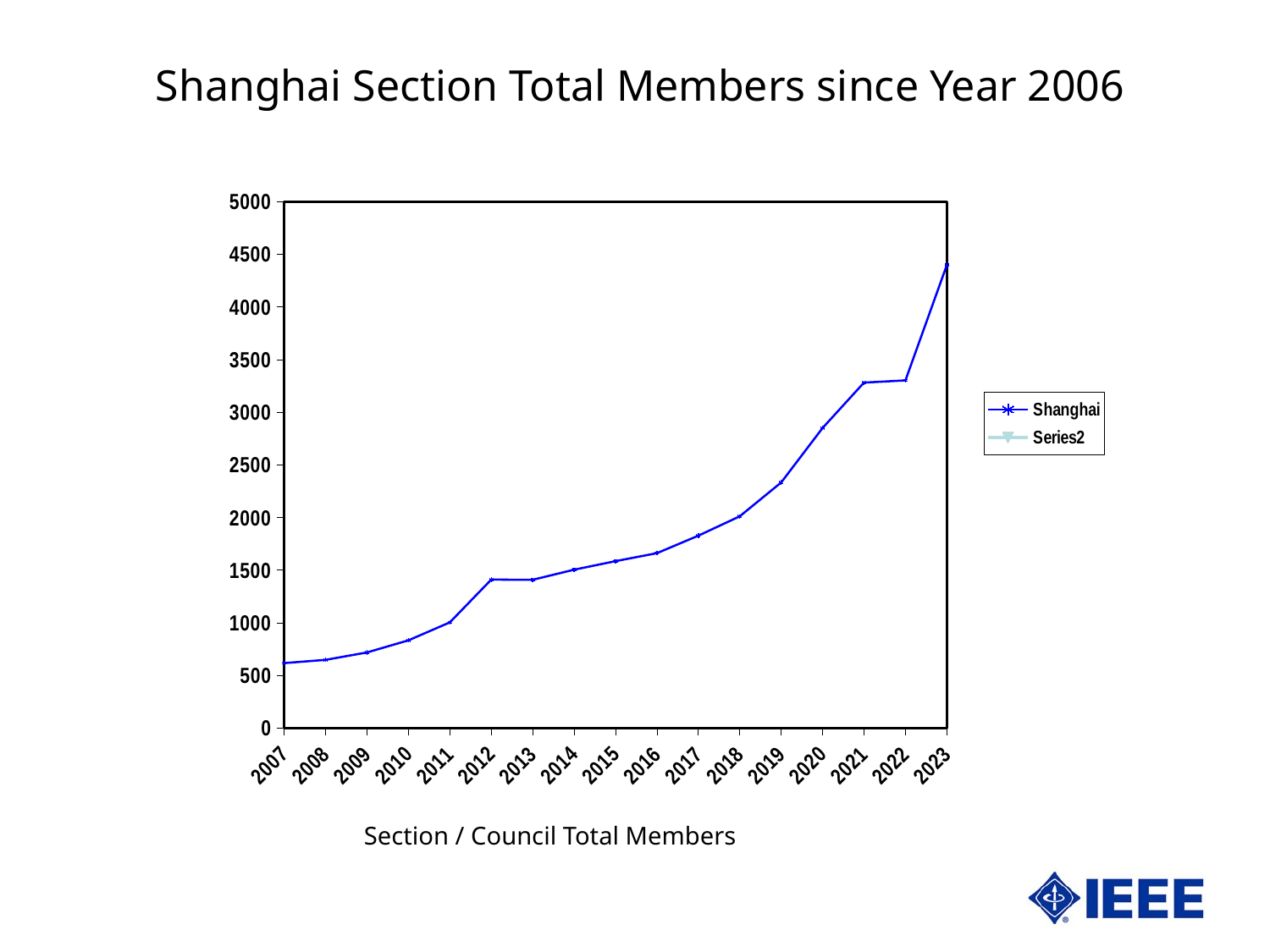
Is the value for Shanghai in 2007 greater or less than 1000? less Is the value for Shanghai in 2023 greater or less than 4000? greater What is the title of the slide's chart? Shanghai Section Total Members since Year 2006 Is the value for Shanghai in 2019 greater or less than 2500? less Which year has the larger Shanghai member value, 2015 or 2020? 2020 Which year has the highest number of Shanghai members? 2023 What kind of chart is shown on the slide? line chart Do the Shanghai member values generally rise or fall from 2007 to 2023? rise How many series does the legend list? 2 How many years are shown on the x axis? 17